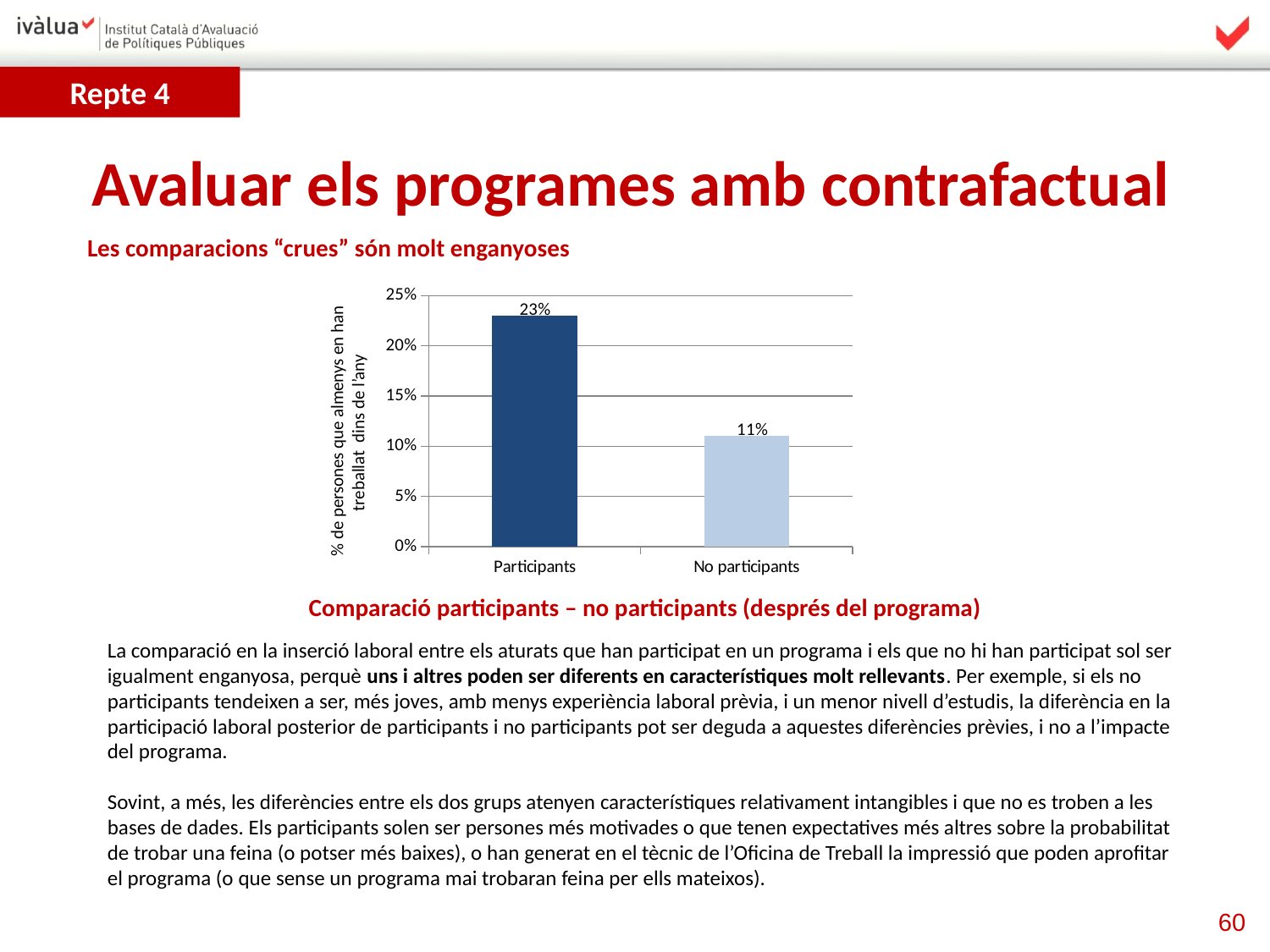
What kind of chart is shown on the slide? bar chart Is the value for No participants greater or less than 15%? less What is the value for No participants? 11% How many categories are shown on the x axis? 2 What is the maximum value shown on the y axis? 25% What is the difference between the values for Participants and No participants? 12% Is the value for Participants greater or less than 20%? greater Which category has the highest value? Participants What is the value for Participants? 23% Which category has the lowest value? No participants What is the caption printed below the chart? Comparació participants – no participants (després del programa) Which is larger, the value for Participants or for No participants? Participants